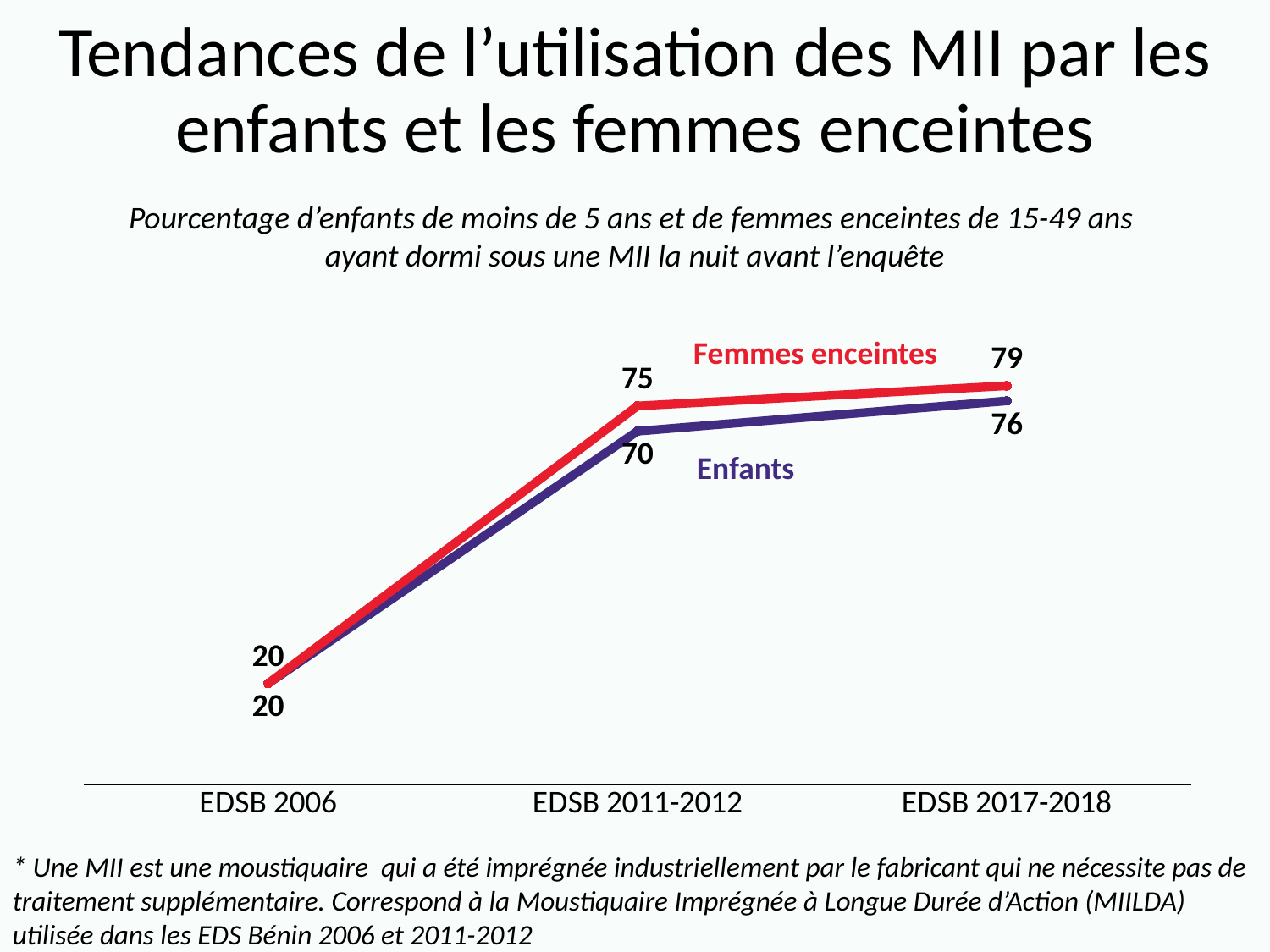
What is the value for Femmes enceintes at EDSB 2011-2012? 75 What is the value for Enfants at EDSB 2006? 20 By how much did the value for Enfants increase from EDSB 2006 to EDSB 2017-2018? 56 How many surveys (points) are shown on the x axis? 3 At which survey is the value for Enfants highest? EDSB 2017-2018 What type of chart is shown on the slide? line chart What is the difference between Femmes enceintes and Enfants at EDSB 2011-2012? 5 At which survey is the value for Femmes enceintes lowest? EDSB 2006 What is the value for Femmes enceintes at EDSB 2017-2018? 79 Which series has the higher value at EDSB 2017-2018, Femmes enceintes or Enfants? Femmes enceintes What is the value for Enfants at EDSB 2011-2012? 70 Does the value for Femmes enceintes rise or fall from EDSB 2006 to EDSB 2017-2018? rise